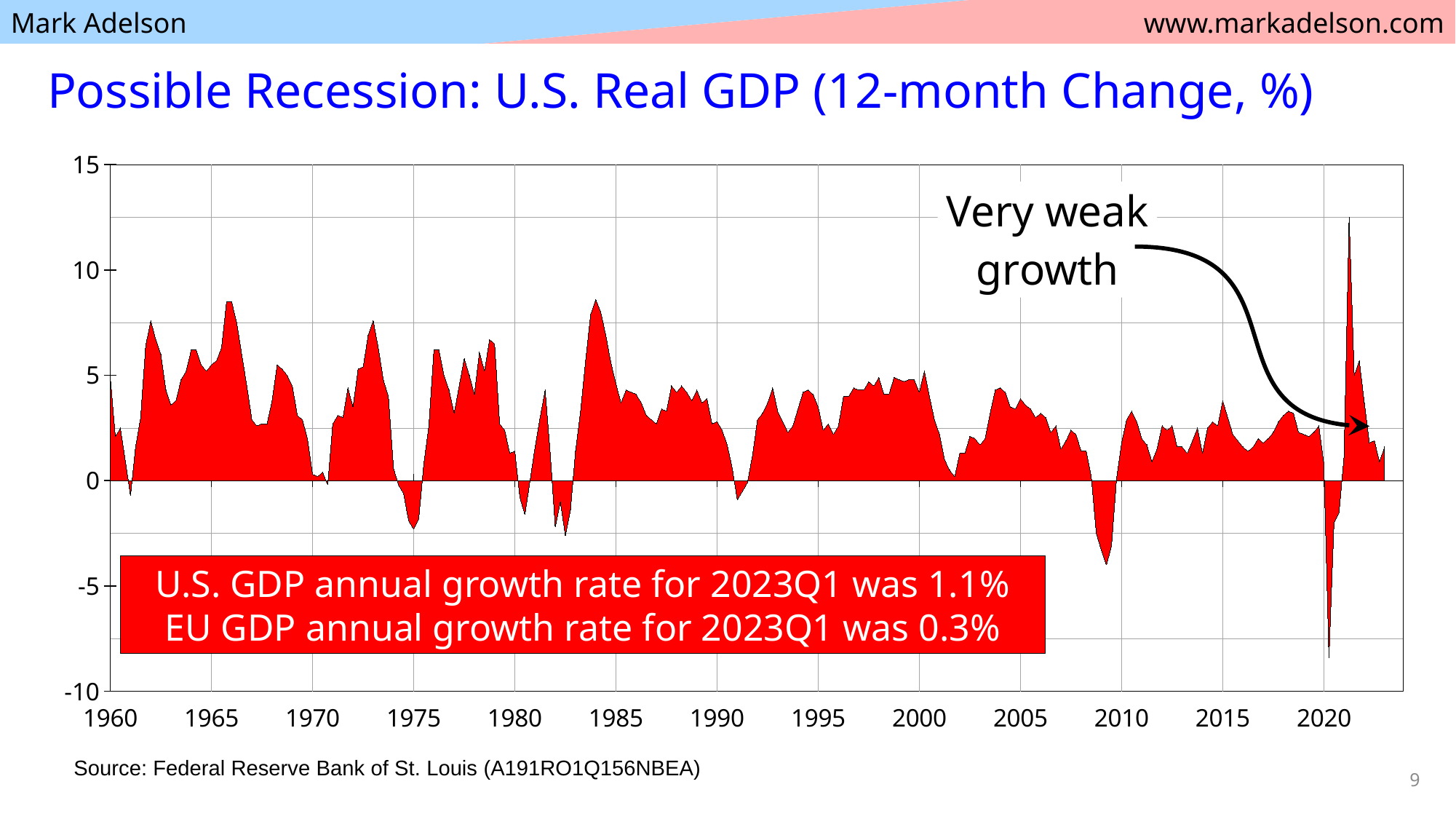
Is the lowest point of the chart, around 2020, greater or less than -5? less According to the slide, what was the U.S. GDP annual growth rate for 2023Q1? 1.1% Which was larger for 2023Q1, the U.S. GDP annual growth rate or the EU GDP annual growth rate? U.S. What kind of chart is shown on the slide? Area chart In roughly which year does the chart reach its highest value? 2021 Is the trough around 2009 greater or less than -2? less According to the slide, what was the EU GDP annual growth rate for 2023Q1? 0.3% What annotation text points to the most recent part of the chart? Very weak growth By how much did the U.S. GDP annual growth rate for 2023Q1 exceed the EU rate for 2023Q1? 0.8% Is the peak around 1984 greater or less than 5? greater What is the title of the chart? Possible Recession: U.S. Real GDP (12-month Change, %)